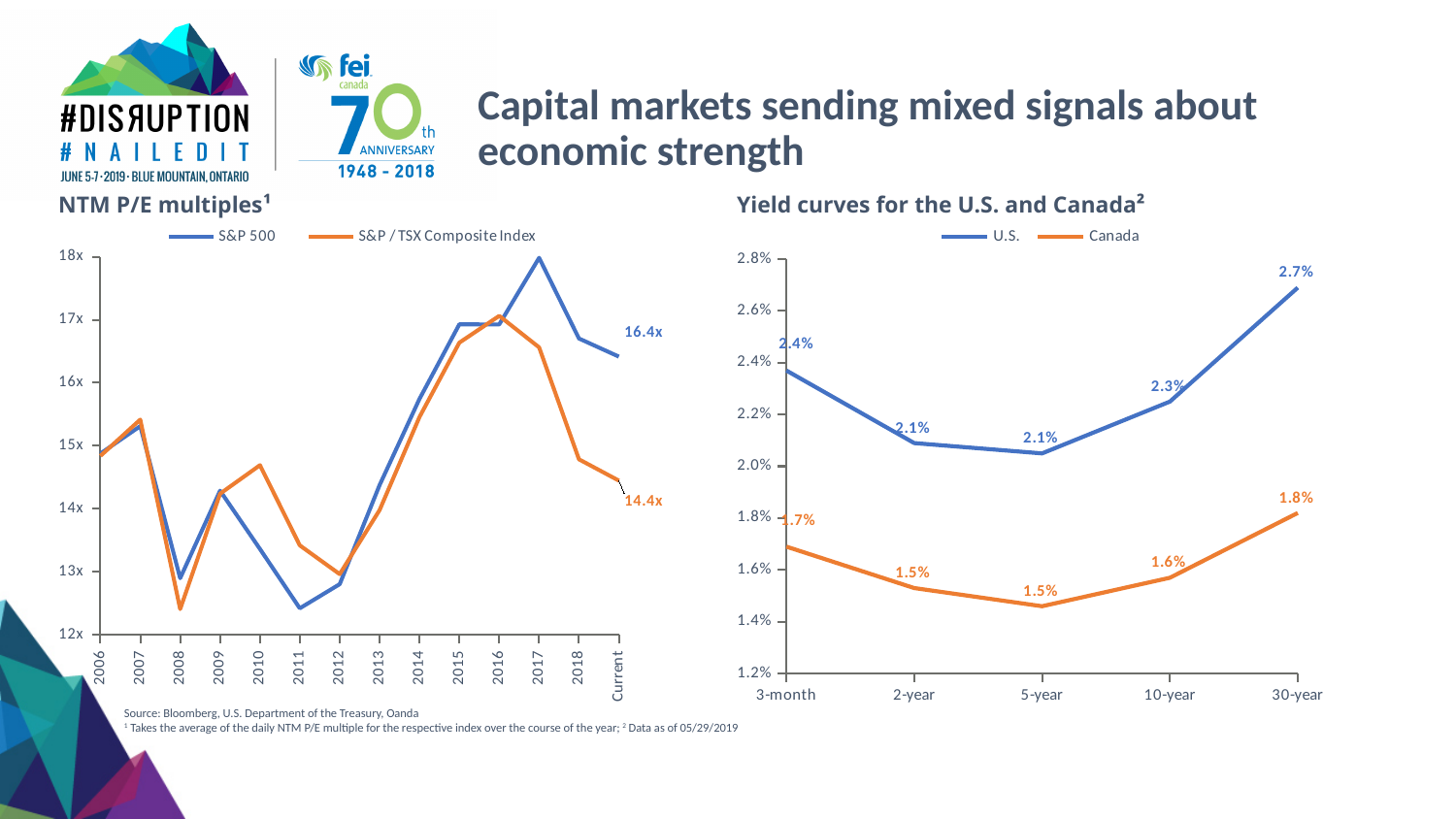
In the 'NTM P/E multiples' chart, is the S&P / TSX Composite Index value for 2008 greater or less than 13x? less In the 'Yield curves for the U.S. and Canada' chart, at which maturity is the U.S. yield highest? 30-year In the 'NTM P/E multiples' chart, what is the Current value for the S&P / TSX Composite Index? 14.4x In the 'Yield curves for the U.S. and Canada' chart, how many maturities are shown on the x axis? 5 In the 'NTM P/E multiples' chart, what is the difference between the Current values of the S&P 500 and the S&P / TSX Composite Index? 2.0x In the 'NTM P/E multiples' chart, which series has the higher value in 2018, S&P 500 or S&P / TSX Composite Index? S&P 500 In the 'Yield curves for the U.S. and Canada' chart, how many series does the legend list? 2 In the 'Yield curves for the U.S. and Canada' chart, what is the difference between the U.S. and Canada yields at the 30-year maturity? 0.9% What kind of chart is the 'NTM P/E multiples' chart? Line chart In the 'Yield curves for the U.S. and Canada' chart, what is the Canada yield at the 3-month maturity? 1.7% In the 'NTM P/E multiples' chart, what is the Current value for the S&P 500? 16.4x In the 'Yield curves for the U.S. and Canada' chart, what is the U.S. yield at the 30-year maturity? 2.7%